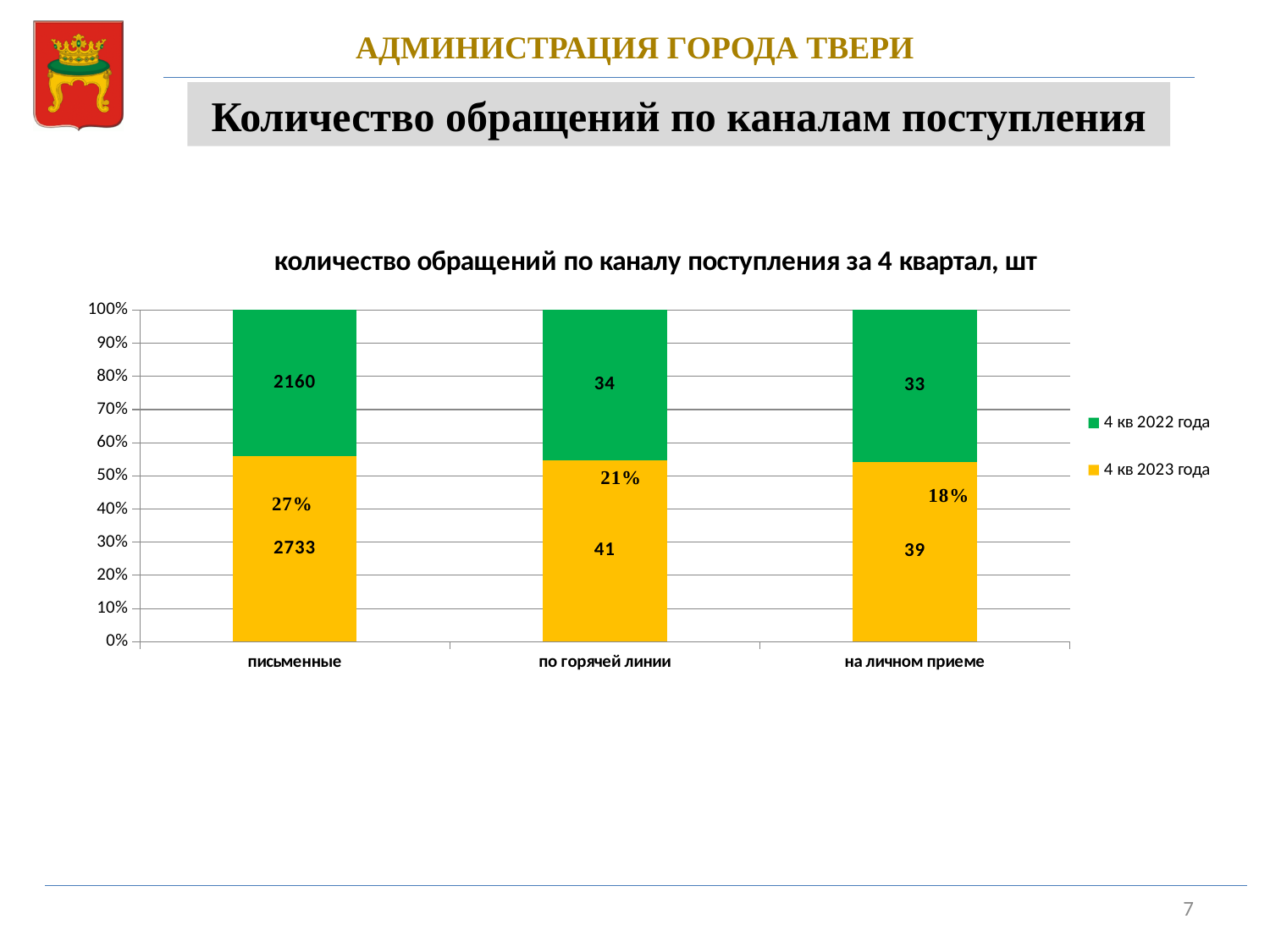
What is the value for письменные in the 4 кв 2023 года series? 2733 Which category has the lowest value in the 4 кв 2022 года series? на личном приеме What is the value for на личном приеме in the 4 кв 2022 года series? 33 What is the title of the chart? количество обращений по каналу поступления за 4 квартал, шт What kind of chart is shown on the slide? stacked bar chart What is the value for по горячей линии in the 4 кв 2023 года series? 41 Which category has the highest value in the 4 кв 2023 года series? письменные How many categories are shown on the x axis? 3 Which is larger for по горячей линии: the 4 кв 2022 года value or the 4 кв 2023 года value? 4 кв 2023 года What is the difference between the 4 кв 2023 года and 4 кв 2022 года values for письменные? 573 What is the value for письменные in the 4 кв 2022 года series? 2160 How many series does the legend list? 2